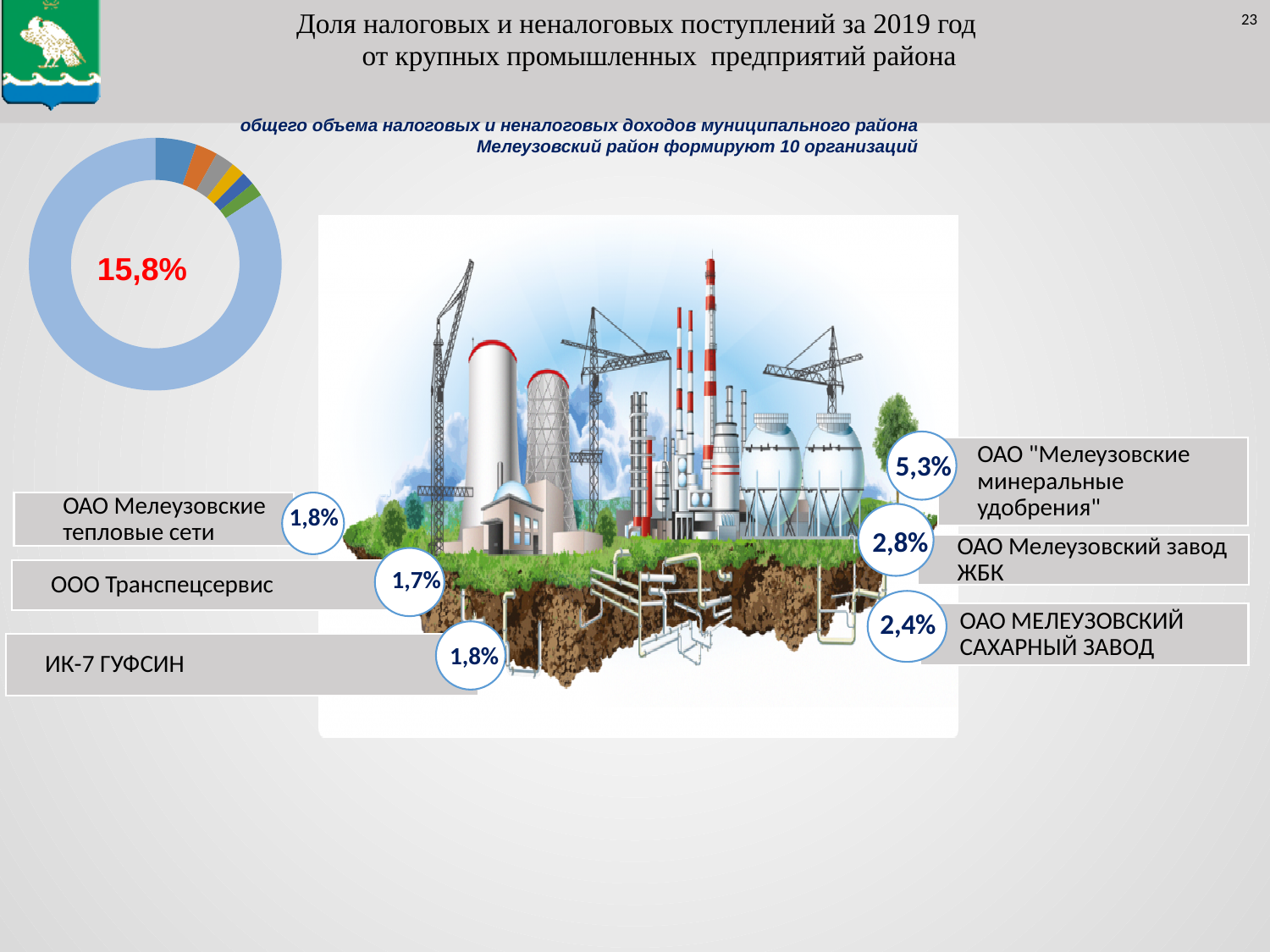
According to the subtitle above the chart, how many organisations form the share of tax and non-tax revenues shown? 10 In the infographic, what share is shown for ОАО Мелеузовский завод ЖБК? 2,8% In the infographic, what share is shown for ОАО "Мелеузовские минеральные удобрения"? 5,3% In the infographic, what share is shown for ОАО МЕЛЕУЗОВСКИЙ САХАРНЫЙ ЗАВОД? 2,4% In the infographic, what is the difference between the shares of ОАО "Мелеузовские минеральные удобрения" and ОАО Мелеузовский завод ЖБК? 2,5 percentage points In the infographic, which organisation has the largest share? ОАО "Мелеузовские минеральные удобрения" What value is printed inside the donut chart on the left of the slide? 15,8% In the infographic, what share is shown for ООО Транспецсервис? 1,7% In the infographic, which organisation has the smallest share? ООО Транспецсервис What kind of chart is shown on the left of the slide? Pie (donut) chart In the infographic, what share is shown for ИК-7 ГУФСИН? 1,8% In the infographic, which has the larger share: ОАО Мелеузовский завод ЖБК or ОАО МЕЛЕУЗОВСКИЙ САХАРНЫЙ ЗАВОД? ОАО Мелеузовский завод ЖБК